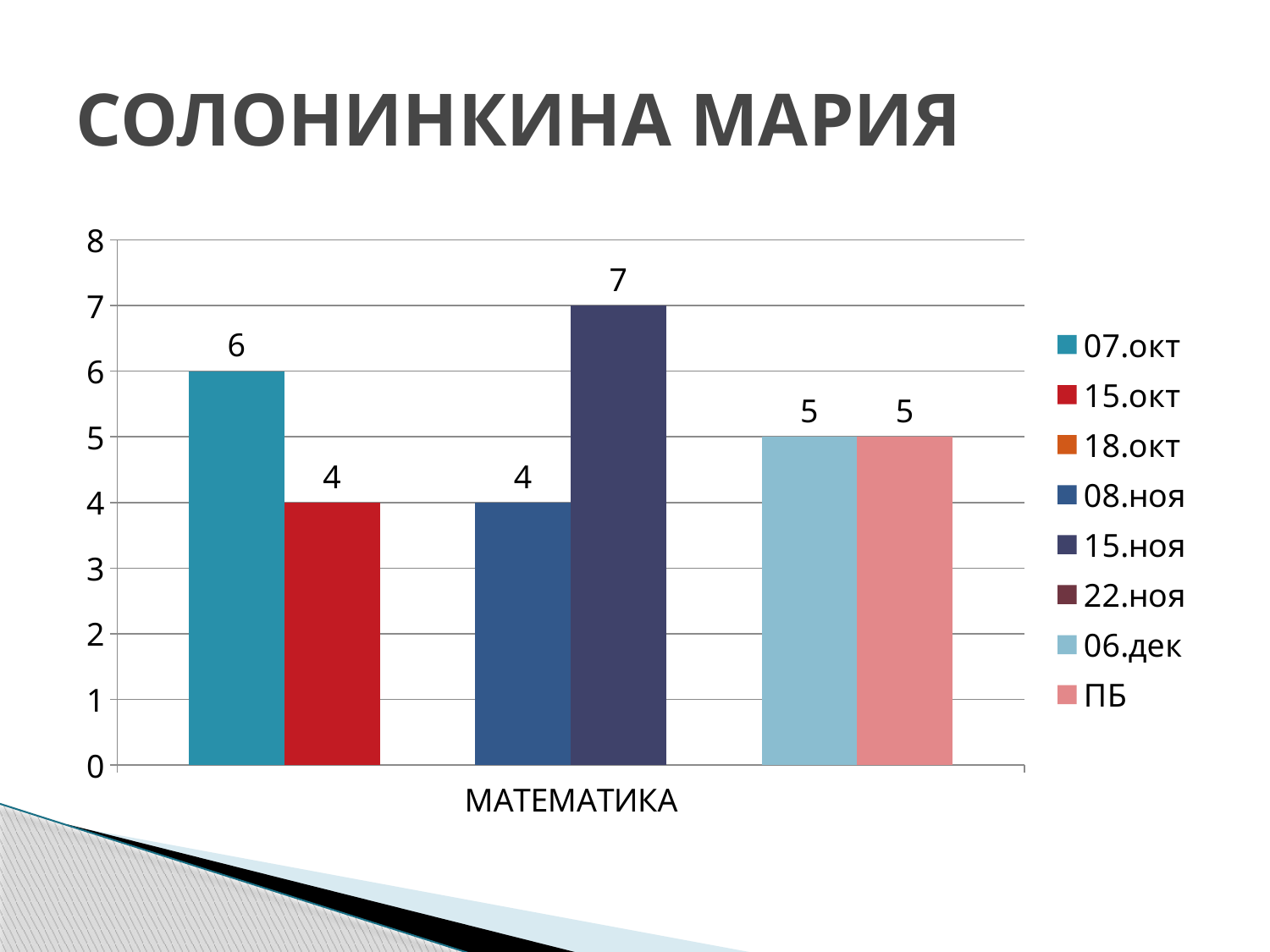
What type of chart is shown on the slide? bar chart What is the value for the 06.дек series? 5 What is the difference between the 15.ноя value and the 08.ноя value? 3 What is the category label shown on the x axis? МАТЕМАТИКА How many series does the legend list? 8 Which is larger, the value for 07.окт or the value for 15.окт? 07.окт What is the value for the ПБ series? 5 What is the value for the 15.ноя series? 7 What is the value for the 15.окт series? 4 What is the difference between the 07.окт value and the 15.окт value? 2 What is the value for the 07.окт series in the МАТЕМАТИКА category? 6 Which series has the highest value in the chart? 15.ноя